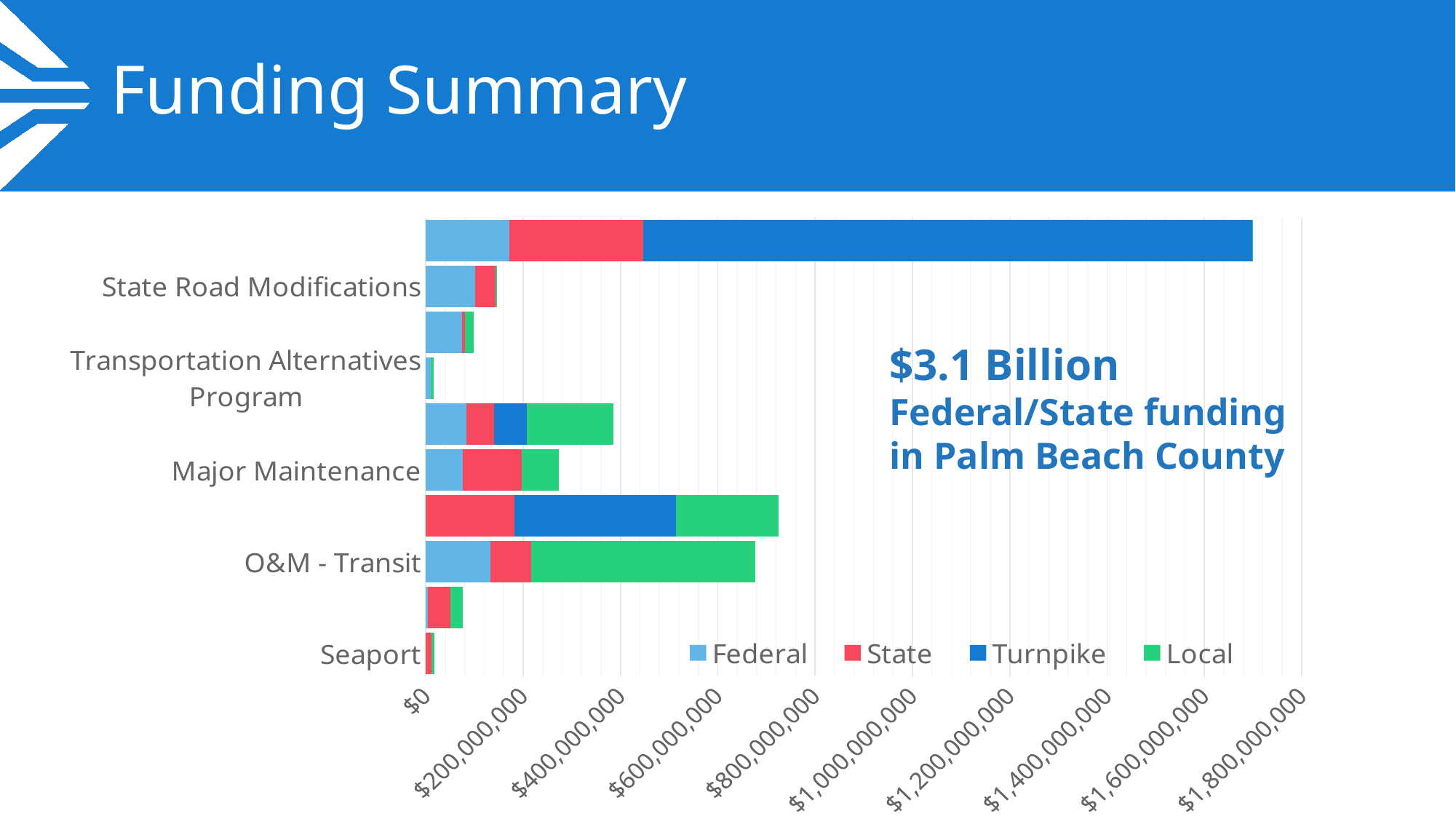
What are the series names listed in the legend? Federal, State, Turnpike, Local What kind of chart is shown on the slide? Stacked bar chart Is the total value for O&M - Transit greater or less than $600,000,000? greater How many series does the legend list? 4 Which series makes up the largest portion of the O&M - Transit bar? Local Is the total value for Major Maintenance greater or less than $400,000,000? less Is the total value for Major Maintenance greater or less than $200,000,000? greater Which has a larger total, O&M - Transit or Major Maintenance? O&M - Transit Which colour represents the Turnpike series in the legend? Dark blue Which has a larger total, State Road Modifications or Seaport? State Road Modifications